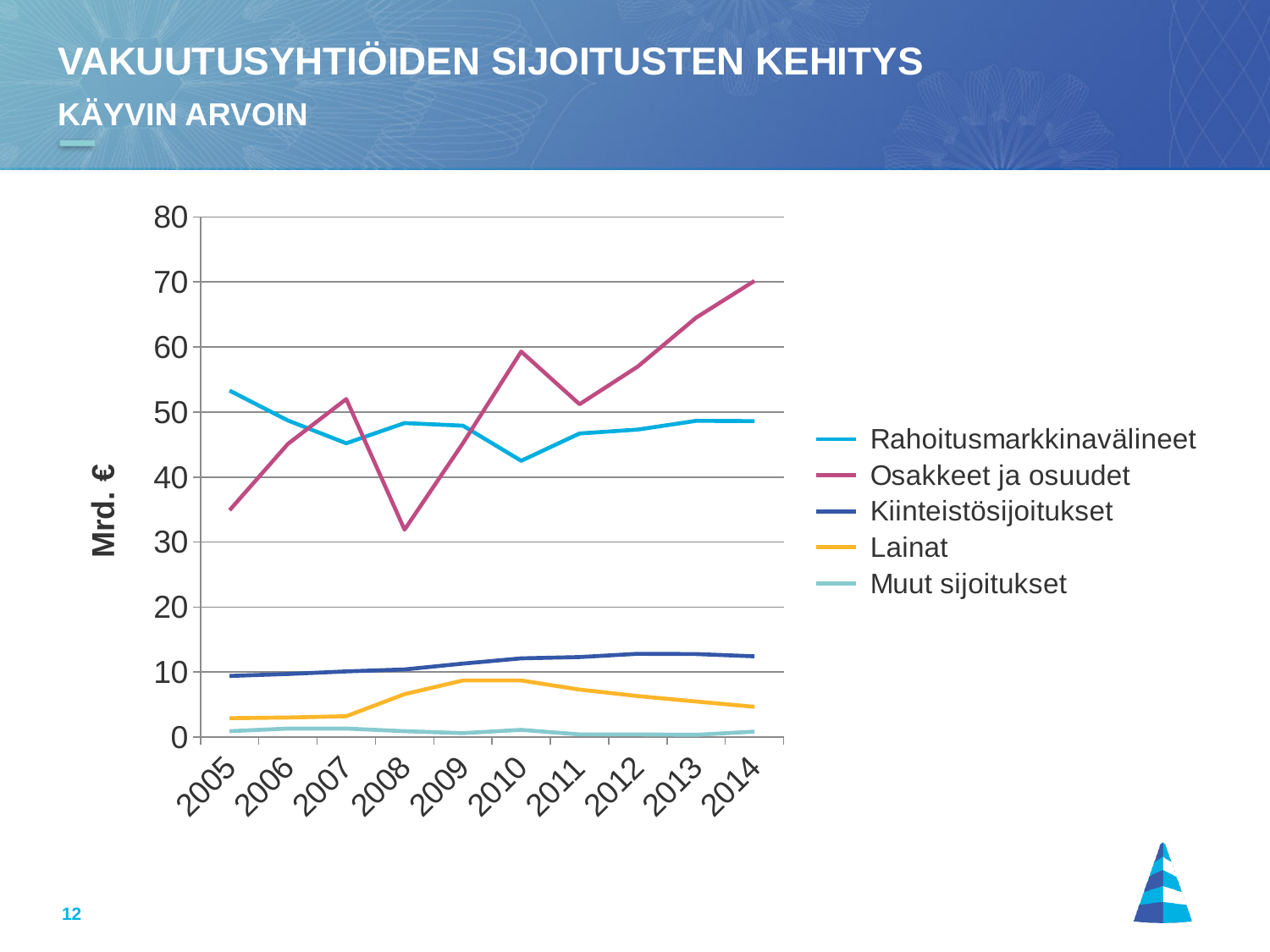
In 2008, which is larger: Rahoitusmarkkinavälineet or Osakkeet ja osuudet? Rahoitusmarkkinavälineet Is the value for Osakkeet ja osuudet in 2008 greater or less than 40? less How many series does the legend list? 5 Which series has the highest value in 2005? Rahoitusmarkkinavälineet Is the value for Lainat in 2009 greater or less than 10? less How many years are shown on the x axis? 10 Which series has the highest value in 2014? Osakkeet ja osuudet In which year is the Osakkeet ja osuudet series at its lowest? 2008 What is the label on the vertical axis? Mrd. € Which series has the lowest values across the whole period? Muut sijoitukset What kind of chart is shown on the slide? line chart Is the value for Osakkeet ja osuudet in 2014 greater or less than 60? greater